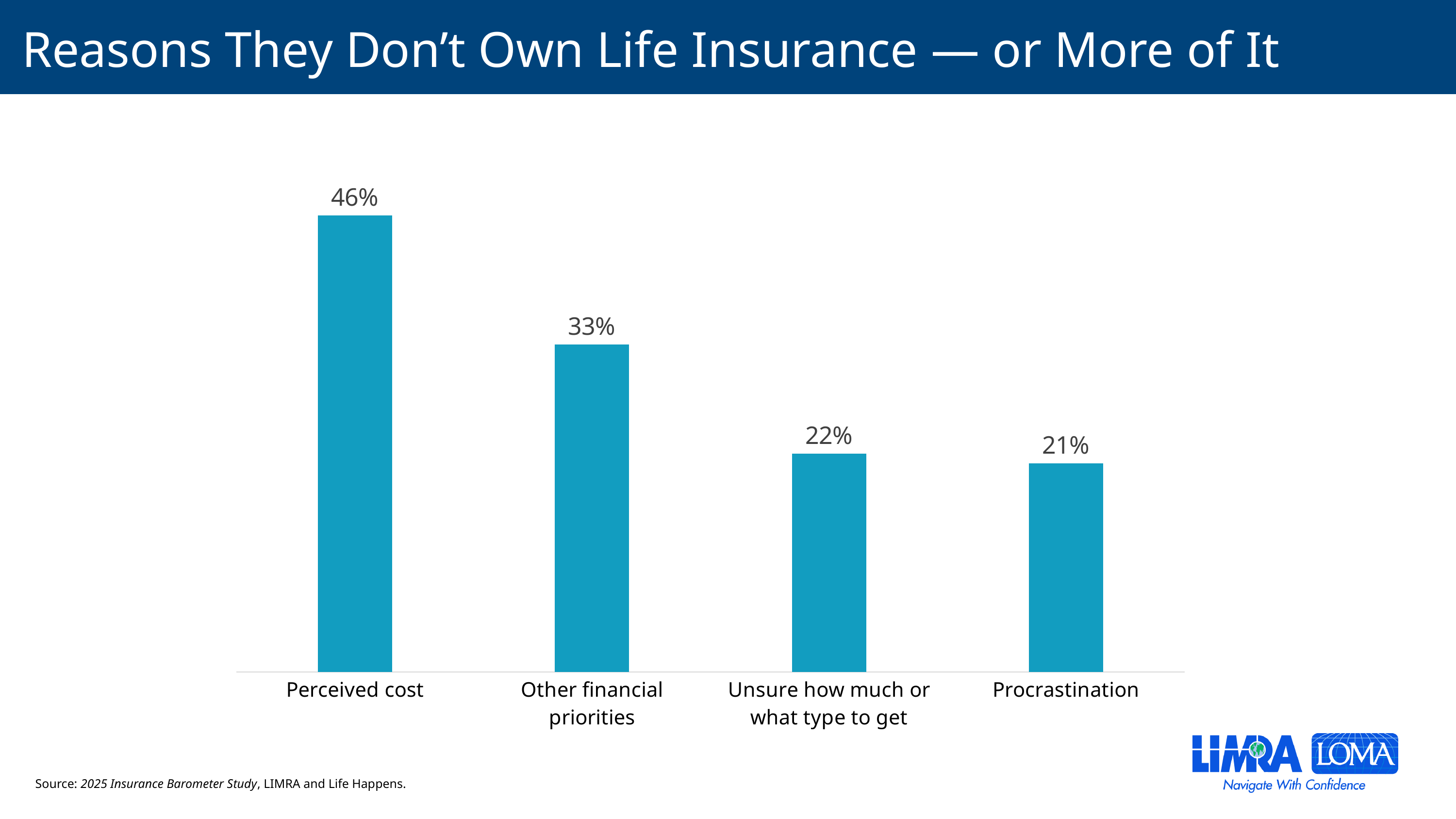
What percentage is shown for Perceived cost? 46% What is the difference between the values for Perceived cost and Other financial priorities? 13% What percentage is shown for Unsure how much or what type to get? 22% What kind of chart is shown on the slide? Bar chart Do the values rise or fall from left to right across the chart? Fall Which reason has the highest value? Perceived cost What is the value for Other financial priorities? 33% How many reasons are shown in the chart? 4 Which is larger, the value for Perceived cost or the value for Unsure how much or what type to get? Perceived cost What is the value for Procrastination? 21% What is the difference between the values for Other financial priorities and Procrastination? 12% Which reason has the lowest value? Procrastination